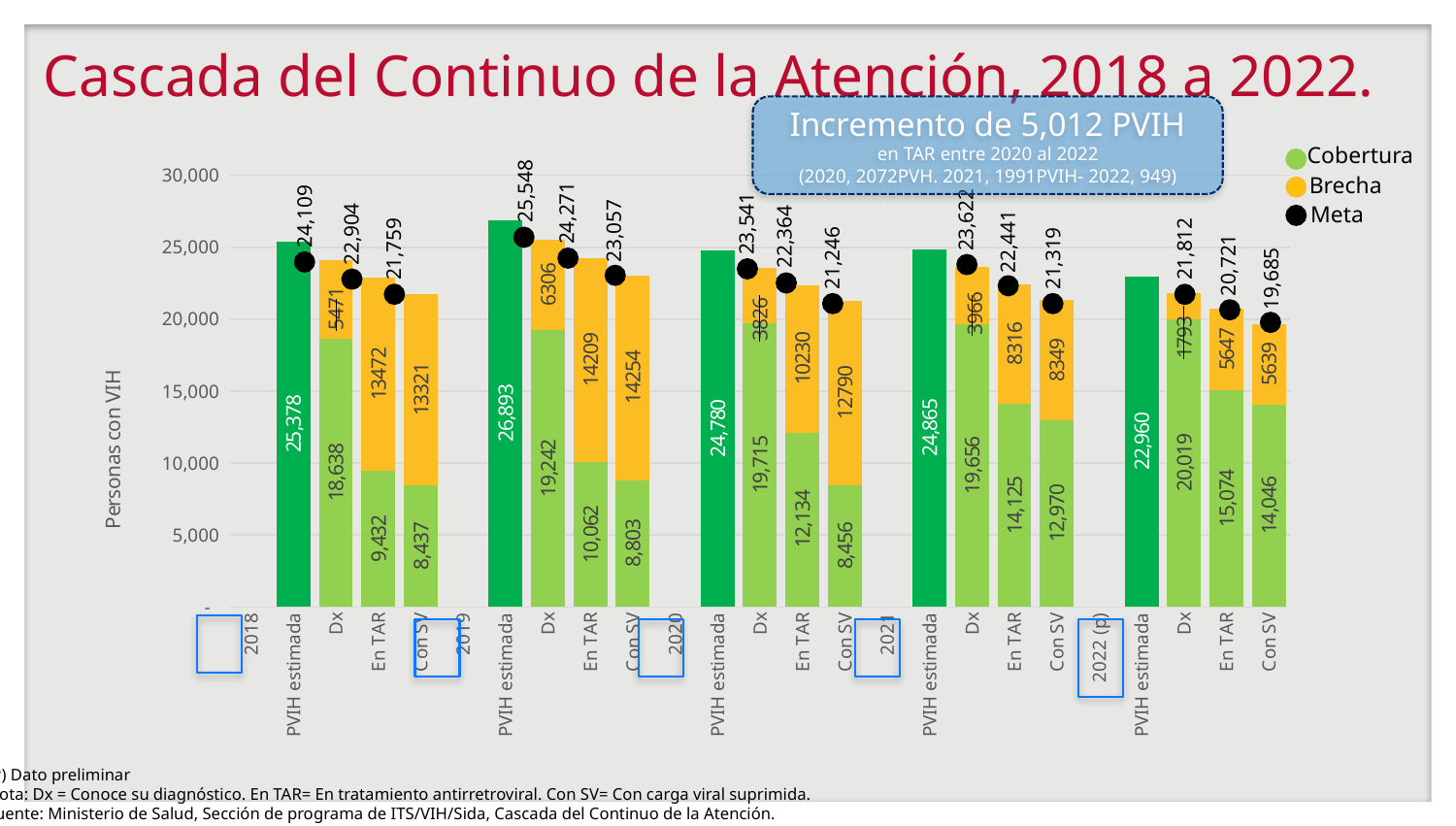
Is the PVIH estimada value for 2018 greater or less than 25,000? greater Does the Cobertura value for En TAR rise or fall from 2018 to 2022 (p)? rise What is the total of the stacked bar for Dx in 2022 (p) (Cobertura plus Brecha)? 21,812 What kind of chart is shown on the slide? bar chart In which year is the PVIH estimada value the lowest? 2022 (p) How many series does the legend list? 3 What is the Brecha value for Dx in 2019? 6306 What is the difference between the Cobertura value for En TAR in 2022 (p) and in 2018? 5,642 What is the Cobertura value for En TAR in 2022 (p)? 15,074 In which year is the PVIH estimada value the highest? 2019 What is the Meta value for En TAR in 2021? 21,319 Which is larger, the Cobertura value for Con SV in 2021 or in 2020? 2021